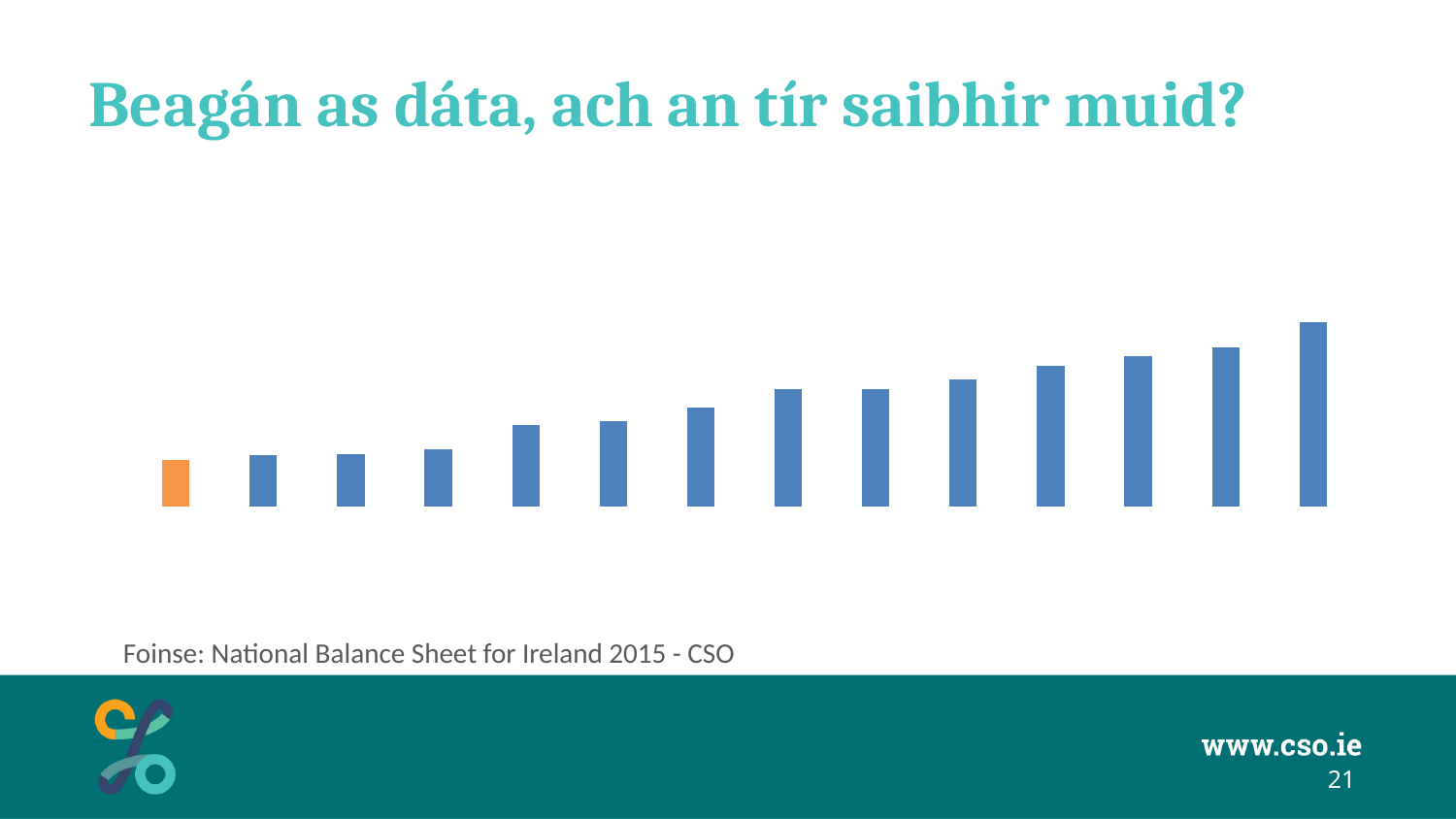
How many bars does the chart contain? 14 Which is taller, the leftmost bar or the rightmost bar? the rightmost bar What source is cited below the chart? National Balance Sheet for Ireland 2015 - CSO What colour is the first (leftmost) bar, which differs from the others? orange Which bar is the tallest in the chart? the rightmost bar Which is taller, the fifth bar from the left or the eighth bar from the left? the eighth bar Which bar is the shortest in the chart? the leftmost (orange) bar What kind of chart is shown on the slide? bar chart Do the bar values generally rise or fall from left to right across the chart? rise